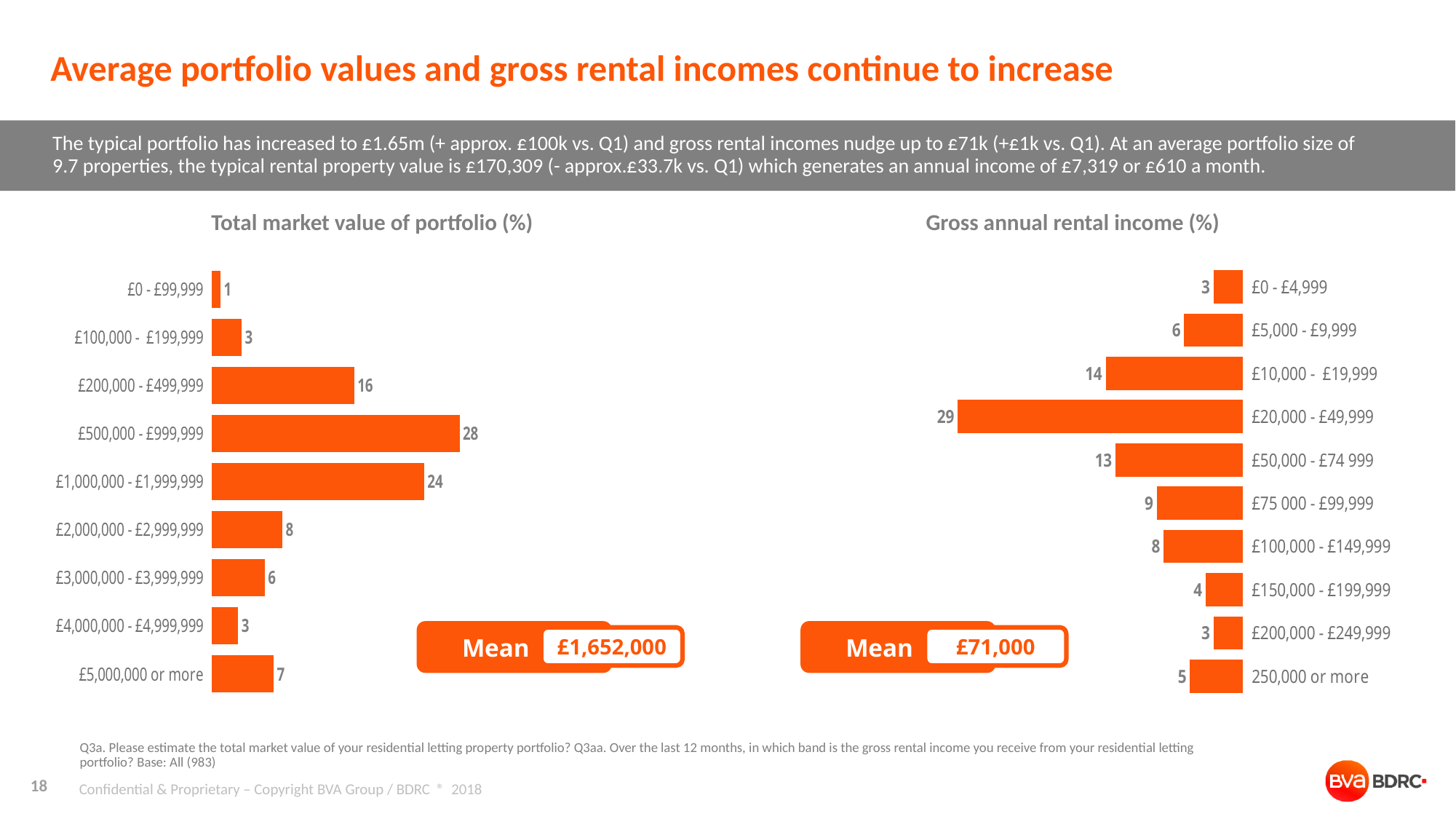
In the 'Total market value of portfolio (%)' chart, which category has the highest value? £500,000 - £999,999 What mean value is shown for the 'Gross annual rental income (%)' chart? £71,000 In the 'Gross annual rental income (%)' chart, what is the difference between the values for £10,000 - £19,999 and £50,000 - £74 999? 1 What type of chart is the 'Gross annual rental income (%)' chart? Bar chart How many categories are shown in the 'Total market value of portfolio (%)' chart? 9 In the 'Total market value of portfolio (%)' chart, what is the difference between the values for £500,000 - £999,999 and £1,000,000 - £1,999,999? 4 In the 'Gross annual rental income (%)' chart, which category has the highest value? £20,000 - £49,999 In the 'Total market value of portfolio (%)' chart, which category has the lowest value? £0 - £99,999 In the 'Total market value of portfolio (%)' chart, what is the value for £500,000 - £999,999? 28 In the 'Total market value of portfolio (%)' chart, which is larger: the value for £200,000 - £499,999 or the value for £5,000,000 or more? £200,000 - £499,999 In the 'Gross annual rental income (%)' chart, what is the value for £20,000 - £49,999? 29 How many categories are shown in the 'Gross annual rental income (%)' chart? 10